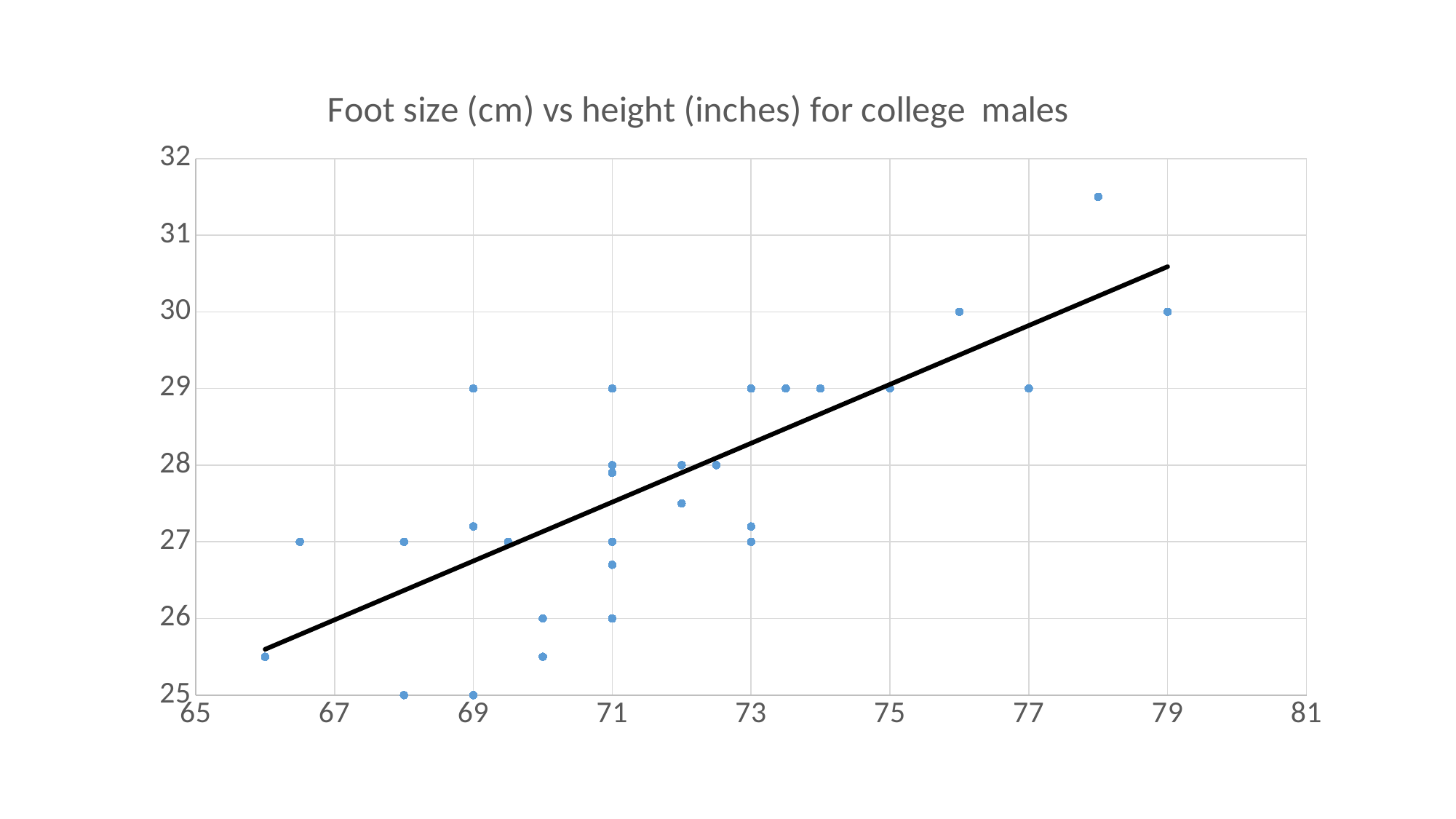
Do foot sizes generally rise or fall as height increases along the x axis? rise What kind of chart is shown on the slide? scatter plot What is the foot size (cm) of the point at a height of 77 inches? 29 Which has the larger foot size: the point at 79 inches or the point at 75 inches? 79 inches Is the foot size of the point at a height of 79 inches greater or less than 29? greater What is the foot size (cm) of the point at a height of 79 inches? 30 Is the foot size of the highest point on the chart greater or less than 31? greater What is the foot size (cm) of the point at a height of 75 inches? 29 What is the highest value shown on the y axis? 32 What is the title of the chart? Foot size (cm) vs height (inches) for college males What is the difference in foot size between the point at 79 inches and the point at 75 inches? 1